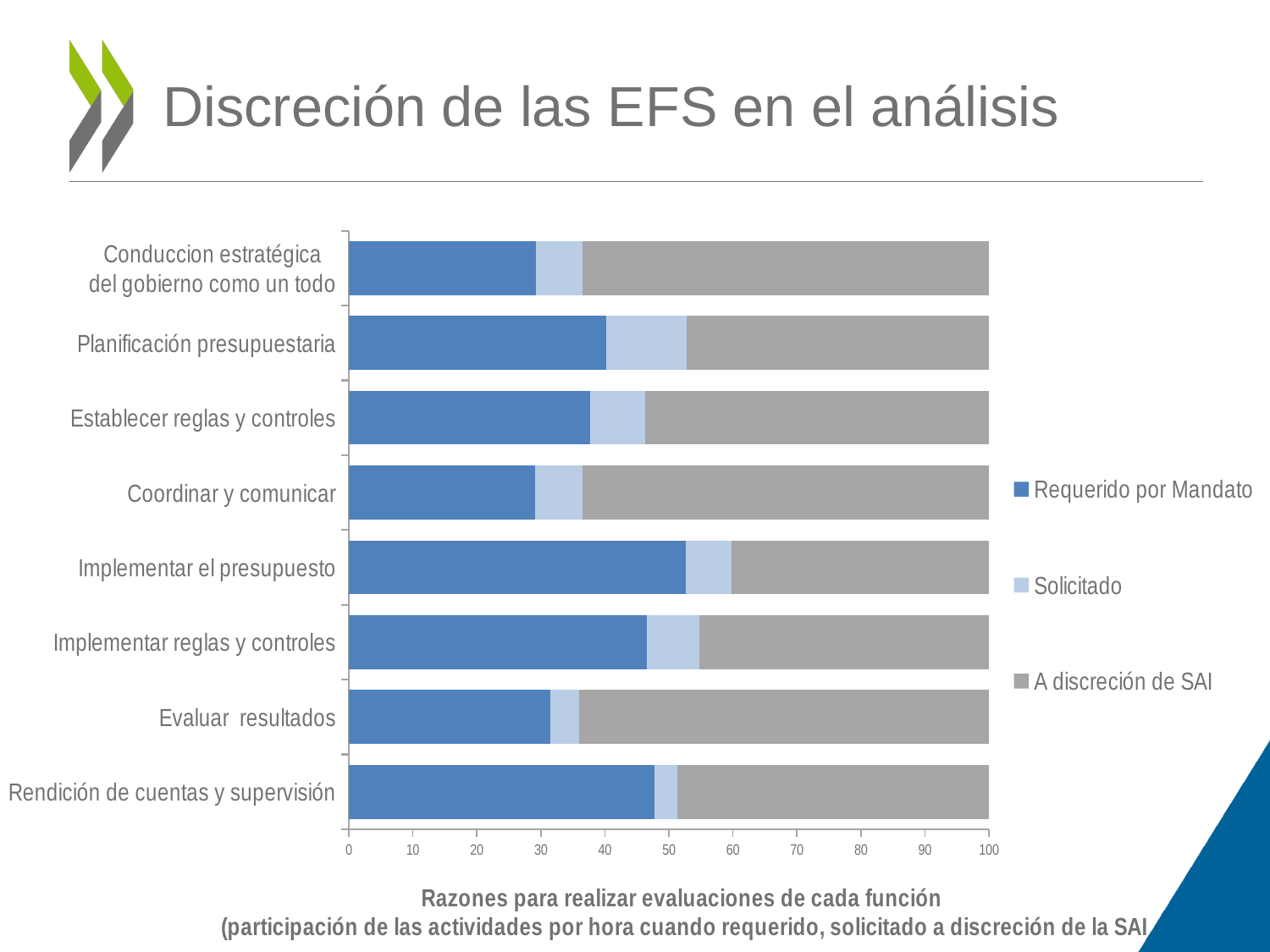
How many categories (functions) are listed on the vertical axis of the chart? 8 What kind of chart is shown on the slide? Stacked bar chart Which category has the largest 'Solicitado' segment? Planificación presupuestaria Which category has the smallest 'A discreción de SAI' segment? Implementar el presupuesto Which has a larger 'Requerido por Mandato' segment: Implementar el presupuesto or Evaluar resultados? Implementar el presupuesto Is the 'Requerido por Mandato' value for Conduccion estratégica del gobierno como un todo greater or less than 40? less At which axis value does every stacked bar end? 100 How many series does the chart's legend list? 3 Which category has the largest 'Requerido por Mandato' segment? Implementar el presupuesto Which series is shown in dark blue in the chart? Requerido por Mandato Is the 'Requerido por Mandato' value for Implementar el presupuesto greater or less than 50? greater What is the highest value shown on the horizontal axis of the chart? 100